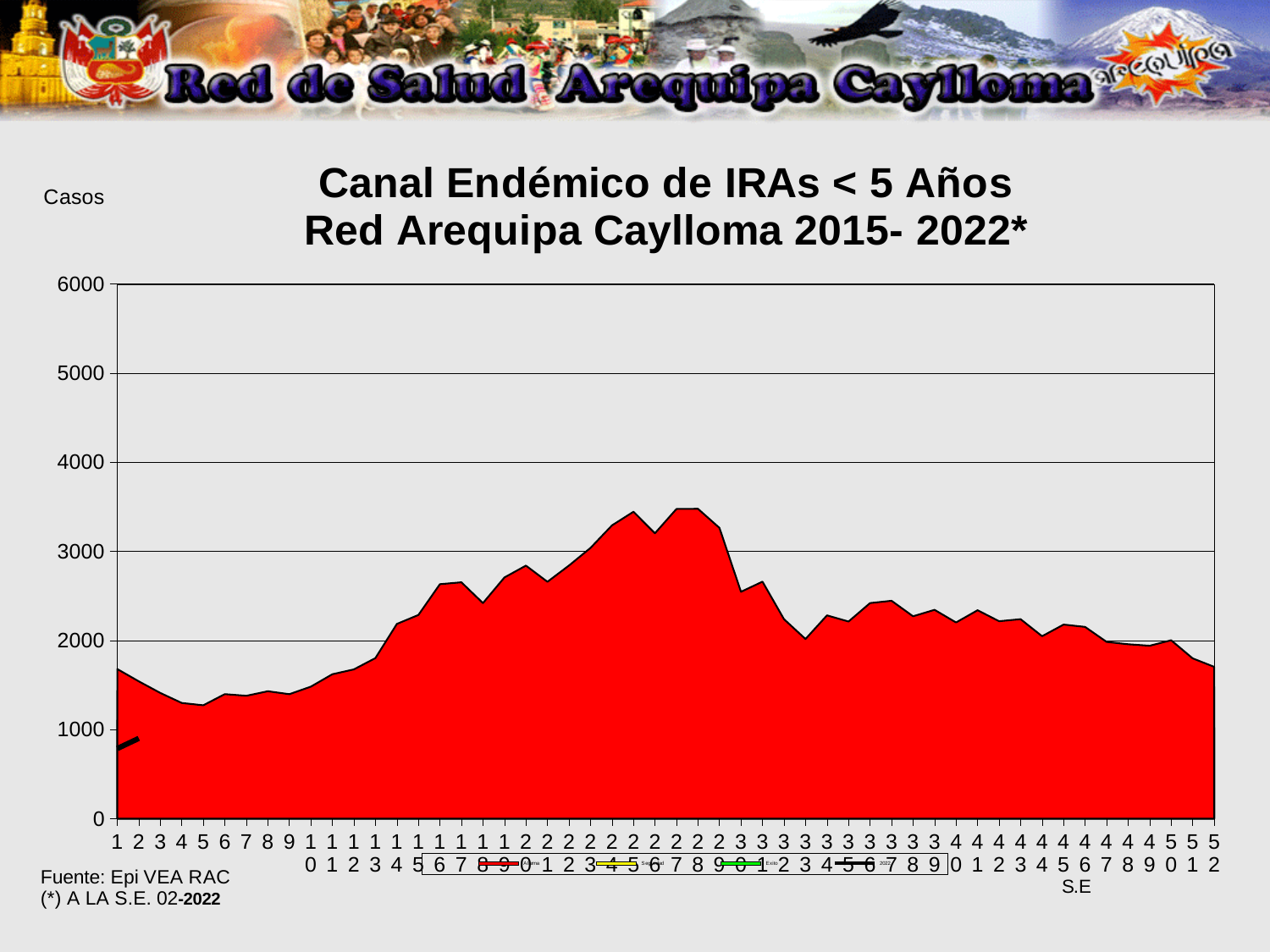
What label is shown on the vertical axis of the chart? Casos Is the value of the red area at week 5 greater or less than 2000? less Is the value of the red area at week 52 greater or less than 2000? less Do the values of the red area rise or fall from week 10 to week 26? rise Is the value of the red area at week 27 greater or less than 3000? greater How many epidemiological weeks (S.E) are shown along the x axis? 52 What is the title of the chart? Canal Endémico de IRAs < 5 Años Red Arequipa Caylloma 2015- 2022* What is the highest value shown on the vertical axis? 6000 What kind of chart is shown on the slide? Area chart Do the values of the red area rise or fall from week 1 to week 5? fall